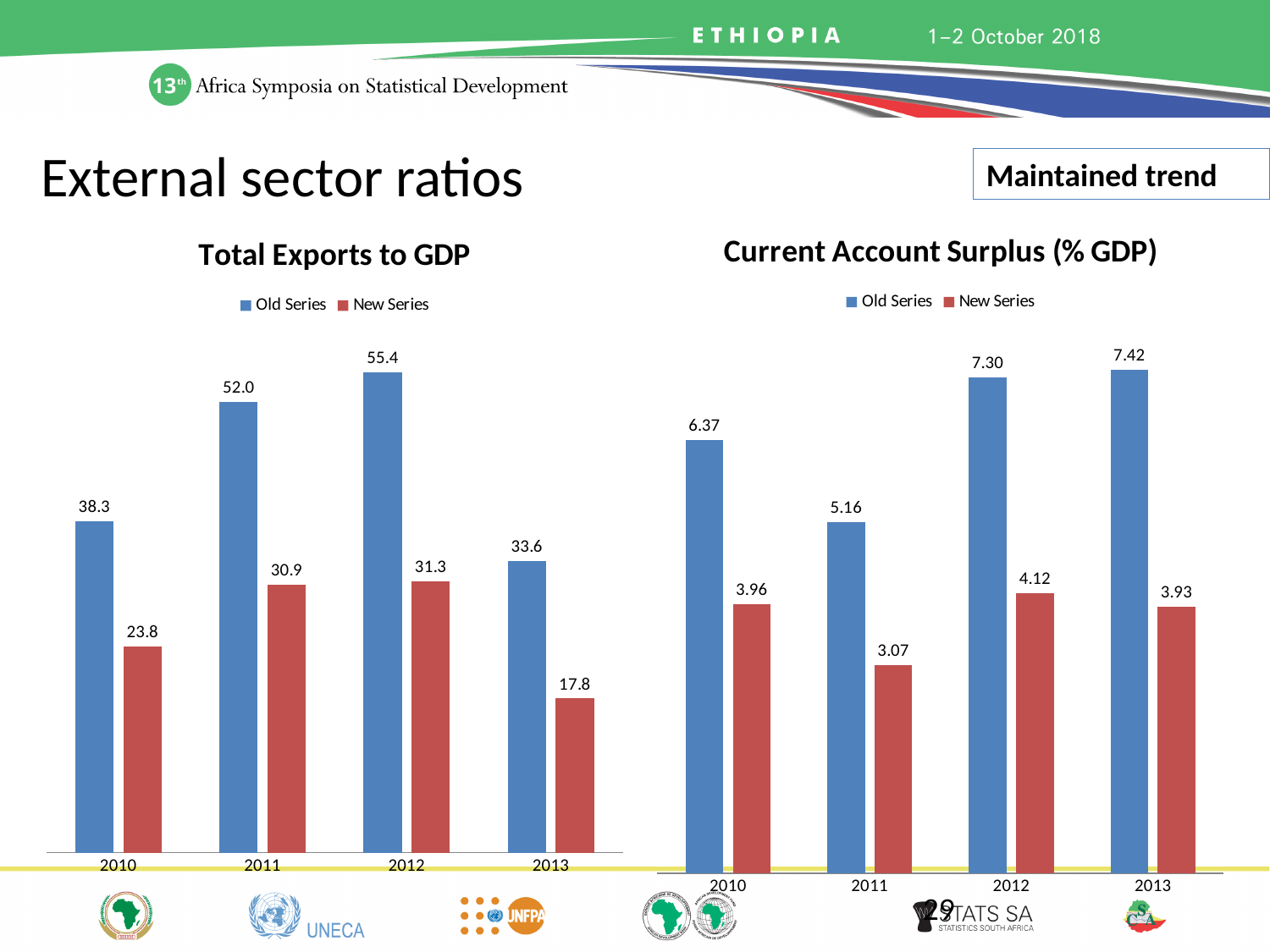
In the Current Account Surplus (% GDP) chart, which is larger: the Old Series value for 2013 or the Old Series value for 2010? Old Series value for 2013 In the Current Account Surplus (% GDP) chart, which year has the lowest New Series value? 2011 What kind of chart is the Total Exports to GDP chart? Bar chart In the Total Exports to GDP chart, what is the difference between the Old Series and New Series values for 2010? 14.5 In the Current Account Surplus (% GDP) chart, what colour are the Old Series bars? Blue In the Total Exports to GDP chart, what is the Old Series value for 2012? 55.4 How many series does the legend of the Current Account Surplus (% GDP) chart list? 2 How many years are shown on the x axis of the Total Exports to GDP chart? 4 In the Total Exports to GDP chart, which year has the highest Old Series value? 2012 In the Total Exports to GDP chart, what is the New Series value for 2013? 17.8 In the Current Account Surplus (% GDP) chart, what is the Old Series value for 2011? 5.16 In the Current Account Surplus (% GDP) chart, what is the New Series value for 2012? 4.12